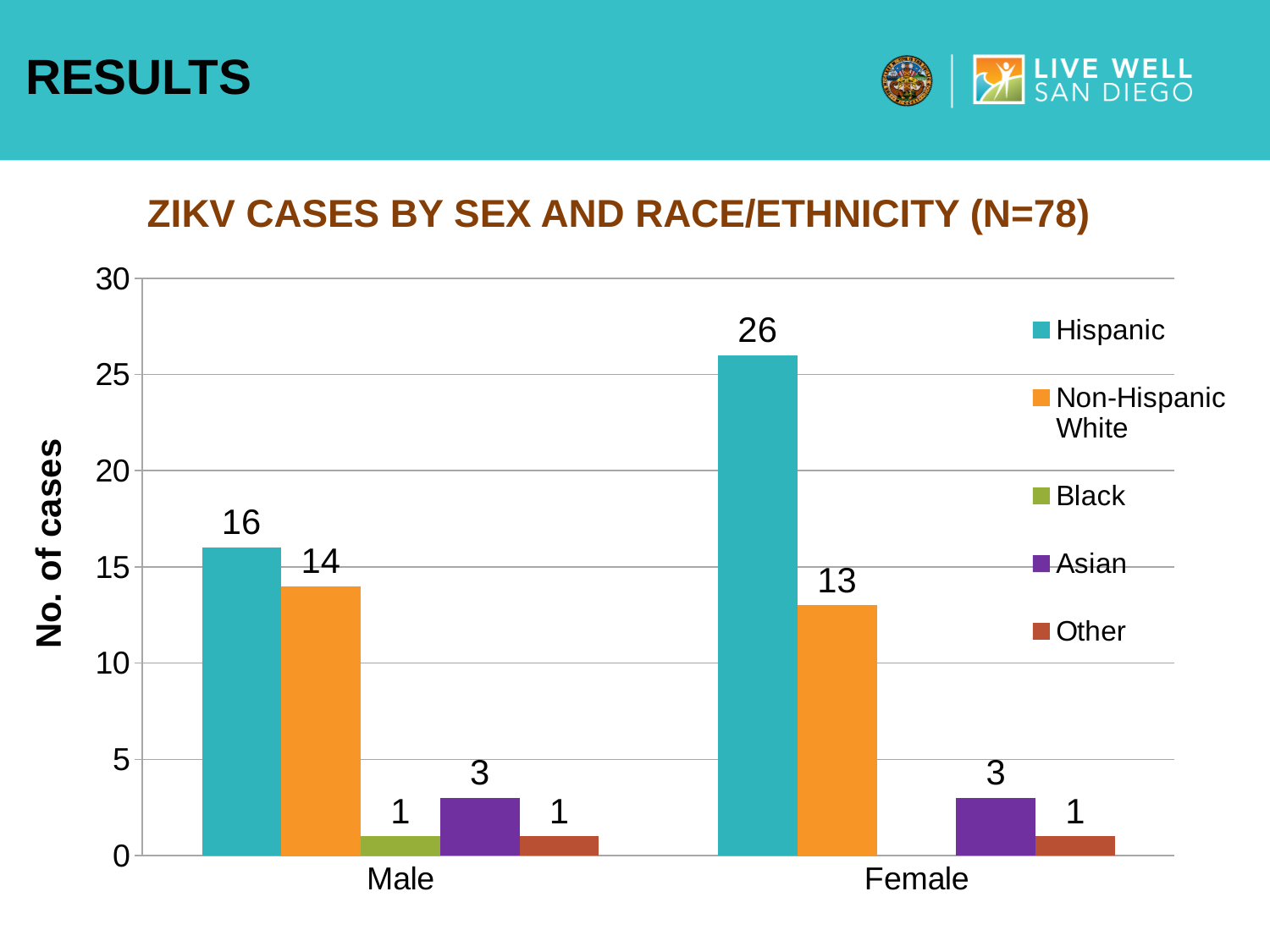
How many Non-Hispanic White ZIKV cases are shown for Male? 14 Which race/ethnicity group has the lowest number of cases among Males? Black and Other (1 each) How many series does the legend list? 5 Which race/ethnicity group has the highest number of cases among Females? Hispanic What is the difference between Hispanic cases for Female and Hispanic cases for Male? 10 What is the label of the y axis? No. of cases How many Black ZIKV cases are shown for Male? 1 How many sex categories are shown on the x axis? 2 How many Hispanic ZIKV cases are shown for Female? 26 Is the value for Hispanic Female cases greater or less than 25? greater What kind of chart is shown on the slide? Bar chart Which is larger: Non-Hispanic White cases for Male or Non-Hispanic White cases for Female? Male